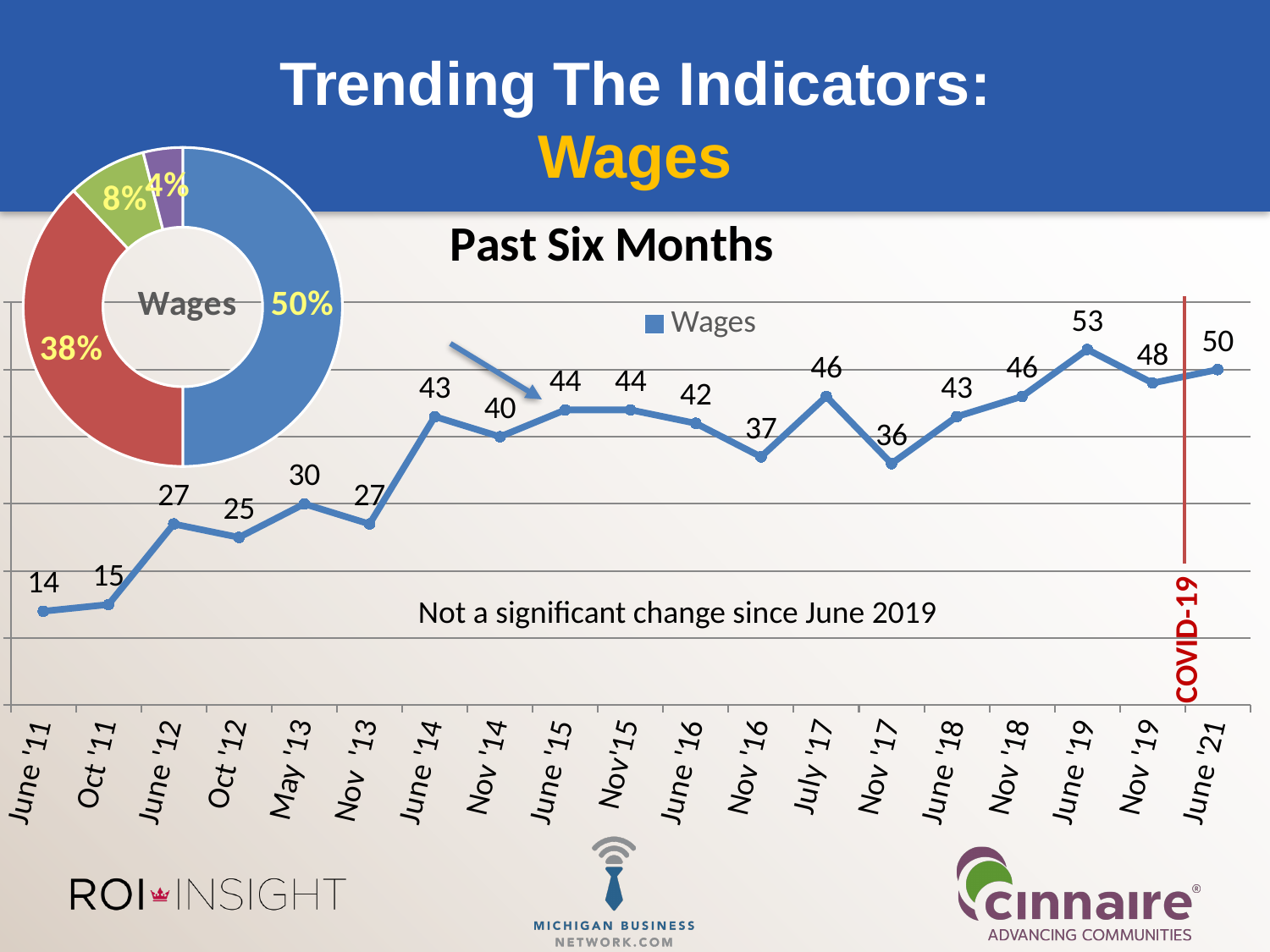
In the line chart, which is larger, the value for July '17 or the value for Nov '16? July '17 In the line chart, what is the value for June '19? 53 What kind of chart is the chart in the top-left corner of the slide? donut (pie) chart In the donut chart, what share does the largest slice represent? 50% In the line chart, what is the value for June '21? 50 In the line chart, which date has the lowest value? June '11 In the line chart, do the values generally rise or fall from June '11 to June '14? rise How many slices does the donut chart have? 4 How many data points are plotted in the line chart? 19 In the line chart, what is the value for Nov '17? 36 In the line chart, which date has the highest value? June '19 In the line chart, what is the difference between the values for June '19 and June '21? 3